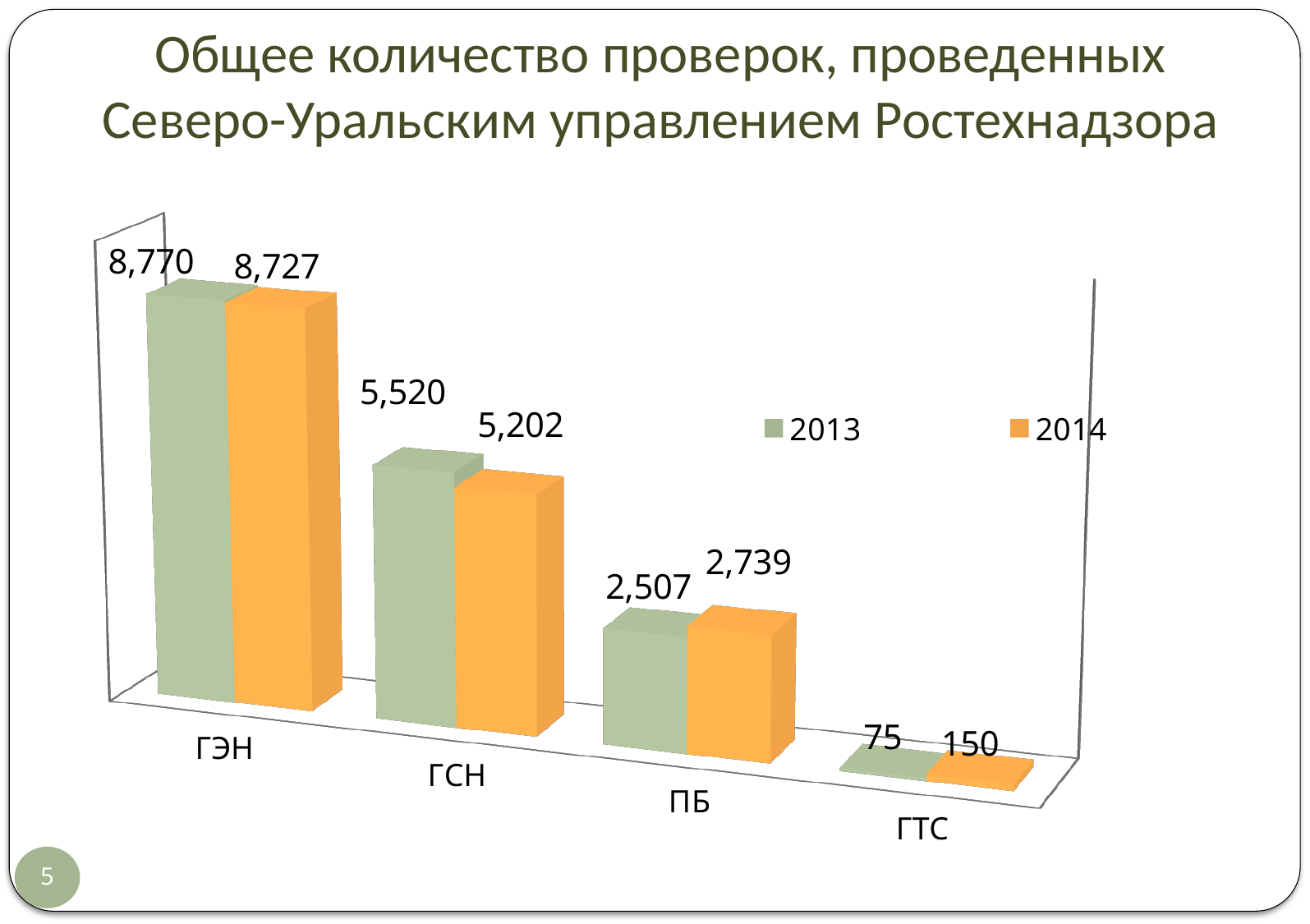
What is the value for ГСН in 2014? 5,202 Which category has the lowest value in 2013? ГТС What is the value for ПБ in 2014? 2,739 How many series does the legend list? 2 How many categories are shown on the x axis? 4 What is the difference between the 2014 and 2013 values for ГТС? 75 Which is larger for ПБ, the 2013 value or the 2014 value? 2014 What kind of chart is shown on the slide? Bar chart What is the difference between the 2013 and 2014 values for ГСН? 318 Which category has the highest value in 2014? ГЭН What is the value for ГТС in 2013? 75 What is the value for ГЭН in 2013? 8,770